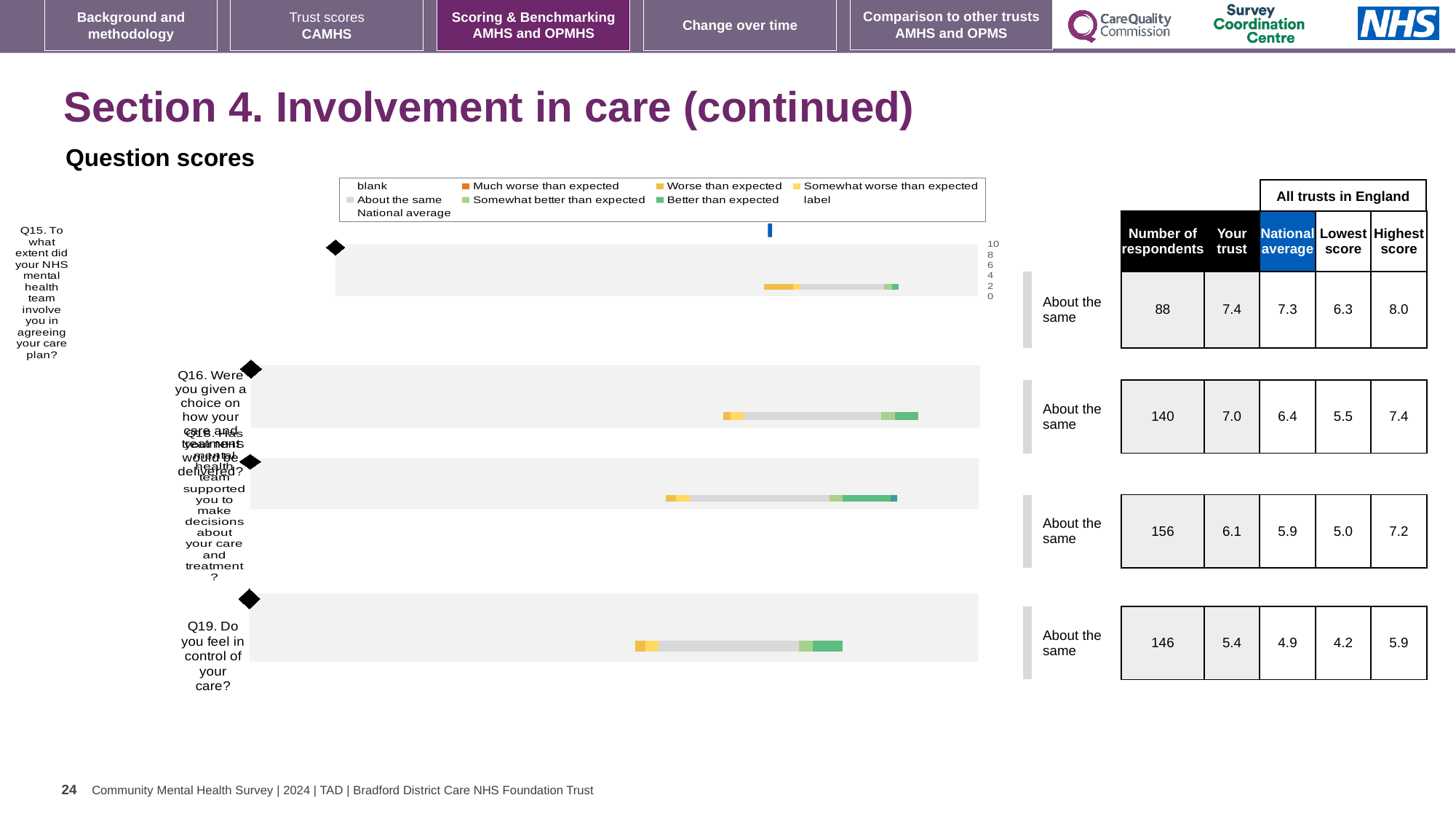
How many entries does the legend of the Question scores chart list? 9 What kind of chart is shown under 'Question scores'? bar chart In the table beside the chart, which question has the lowest 'Your trust' score? Q19 In the Question scores chart legend, which entry is shown in orange? Much worse than expected In the table beside the chart, how many respondents answered Q18? 156 In the table beside the chart, is the highest score for Q19 larger or smaller than the highest score for Q15? smaller In the table beside the chart, which question has the highest number of respondents? Q18 What is the benchmark category shown for Q19 'Do you feel in control of your care?'? About the same In the table beside the chart, what is the national average for Q16? 6.4 In the table beside the chart, what is the difference between the 'Your trust' score and the national average for Q18? 0.2 How many questions (categories) are plotted in the Question scores chart? 4 In the table beside the chart, what is the 'Your trust' score for Q15? 7.4